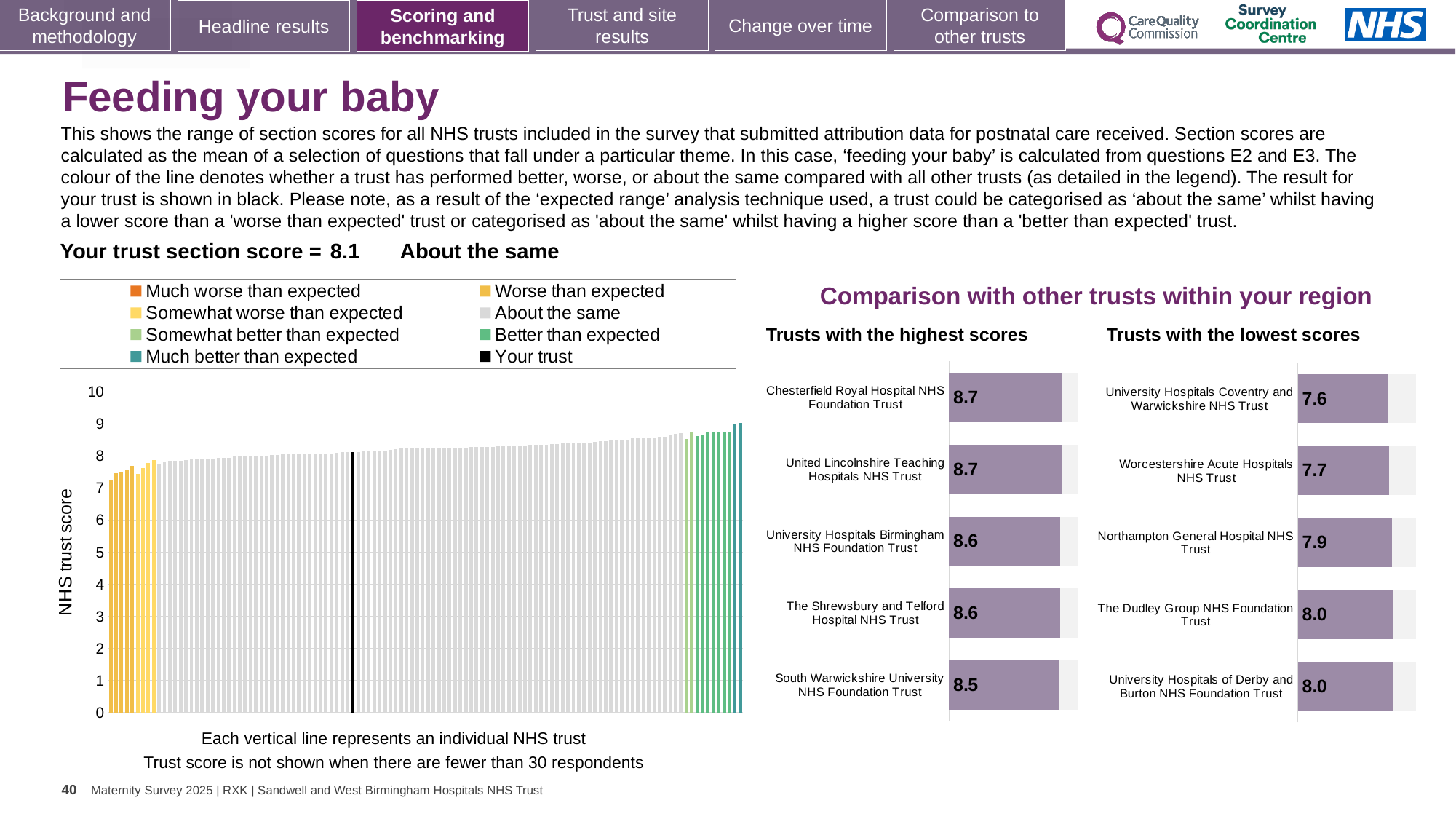
In the 'Trusts with the lowest scores' chart, which has the higher score: Northampton General Hospital NHS Trust or Worcestershire Acute Hospitals NHS Trust? Northampton General Hospital NHS Trust In the 'Trusts with the lowest scores' chart, what is the difference between the scores of Worcestershire Acute Hospitals NHS Trust and University Hospitals Coventry and Warwickshire NHS Trust? 0.1 How many entries does the legend of the 'NHS trust score' chart on the left list? 8 How many trusts are shown in the 'Trusts with the highest scores' chart? 5 What kind of chart is the 'NHS trust score' chart on the left of the slide? Bar chart In the 'Trusts with the lowest scores' chart, what is the score for The Dudley Group NHS Foundation Trust? 8.0 In the 'Trusts with the lowest scores' chart, what is the score for Northampton General Hospital NHS Trust? 7.9 In the 'Trusts with the lowest scores' chart, what is the score for University Hospitals Coventry and Warwickshire NHS Trust? 7.6 In the 'Trusts with the lowest scores' chart, which trust has the lowest score? University Hospitals Coventry and Warwickshire NHS Trust In the 'Trusts with the highest scores' chart, what is the difference between the scores of Chesterfield Royal Hospital NHS Foundation Trust and South Warwickshire University NHS Foundation Trust? 0.2 In the 'Trusts with the highest scores' chart, what is the score for Chesterfield Royal Hospital NHS Foundation Trust? 8.7 In the 'Trusts with the highest scores' chart, which trust has the lowest score? South Warwickshire University NHS Foundation Trust